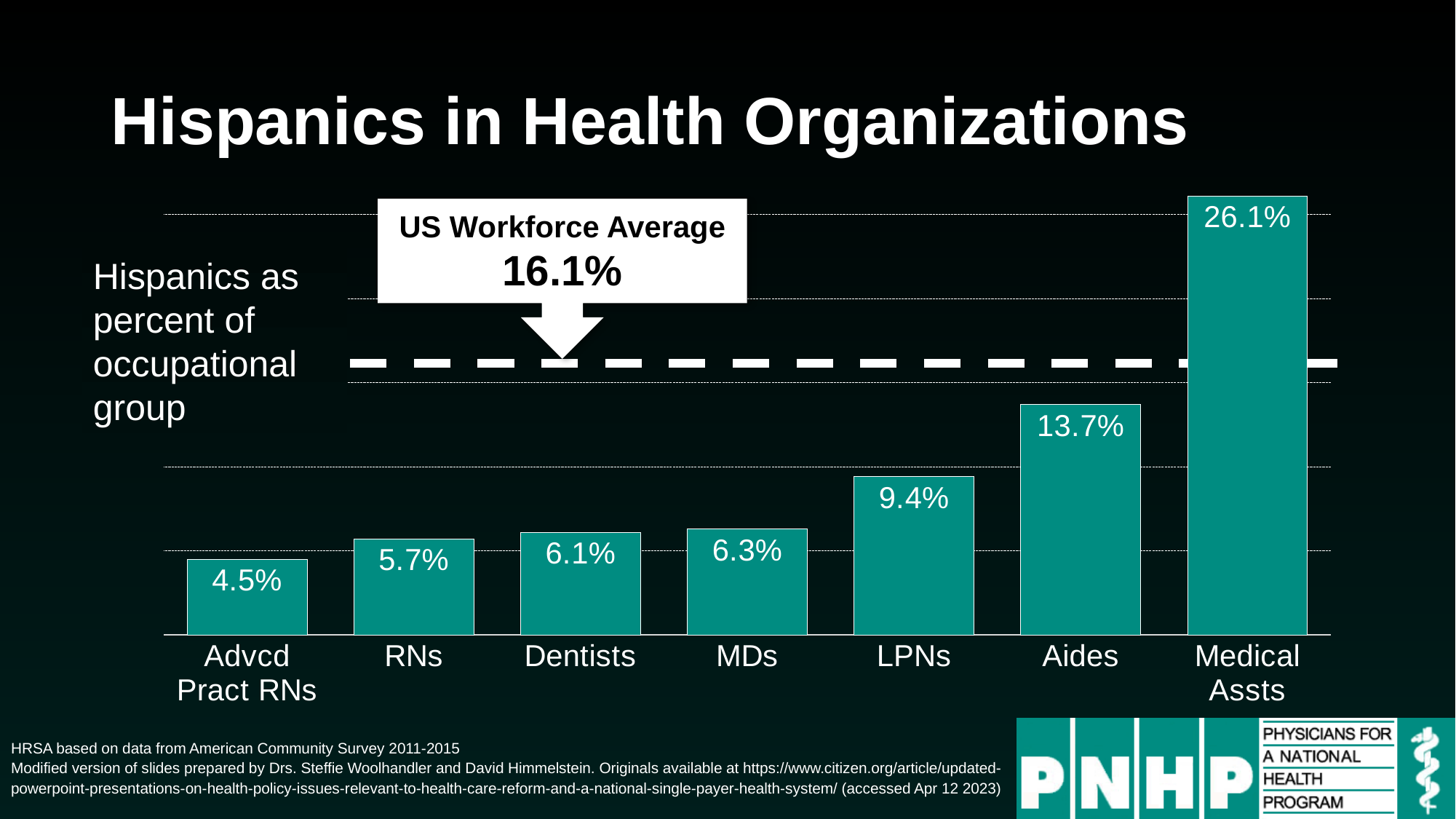
Do the values rise or fall moving from left to right across the x axis? Rise What is the difference between the values for Medical Assts and Advcd Pract RNs? 21.6% Which occupational group has the lowest percentage of Hispanics? Advcd Pract RNs Which is larger, the value for MDs or the value for Dentists? MDs What is the value shown for Advcd Pract RNs? 4.5% What kind of chart is shown on the slide? Bar chart What US Workforce Average is marked by the dashed line on the chart? 16.1% Which occupational group has the highest percentage of Hispanics? Medical Assts What is the difference between the values for Aides and LPNs? 4.3% What is the value shown for LPNs? 9.4% What percentage of Medical Assts are Hispanic according to the chart? 26.1% How many occupational groups are shown in the chart? 7